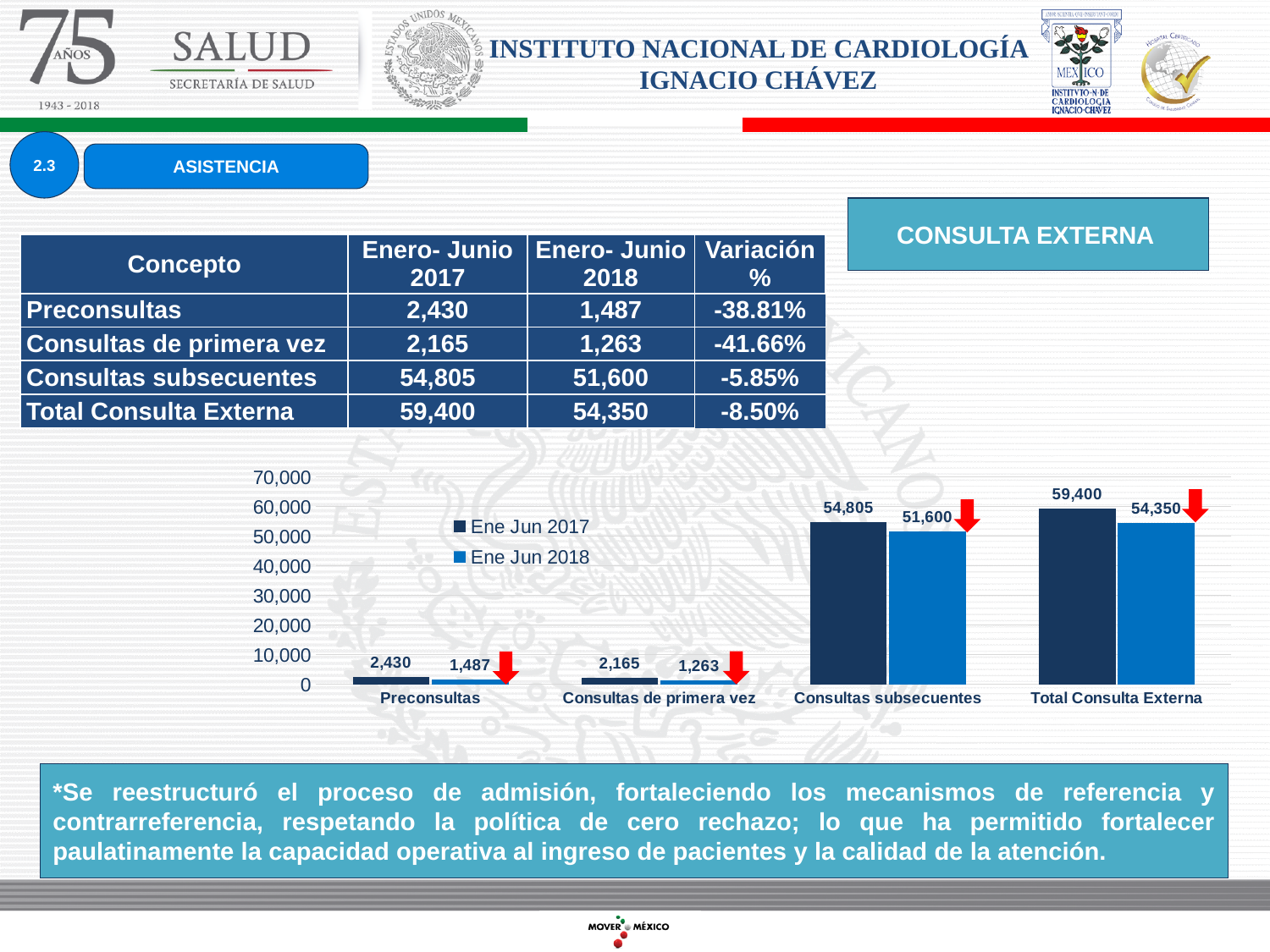
Which category has the highest value in the Ene Jun 2017 series? Total Consulta Externa Which category has the lowest value in the Ene Jun 2018 series? Consultas de primera vez What kind of chart is shown on the slide? bar chart What is the difference between the Ene Jun 2017 and Ene Jun 2018 values for Consultas subsecuentes? 3,205 What is the value for Consultas subsecuentes in the Ene Jun 2017 series? 54,805 What is the maximum value shown on the chart's y axis? 70,000 What is the value for Preconsultas in the Ene Jun 2018 series? 1,487 Is the Ene Jun 2018 value for Total Consulta Externa greater or less than 50,000? greater What is the value for Total Consulta Externa in the Ene Jun 2018 series? 54,350 How many series does the chart legend list? 2 How many categories are shown on the x axis of the chart? 4 Which is larger for Consultas de primera vez: the Ene Jun 2017 value or the Ene Jun 2018 value? Ene Jun 2017